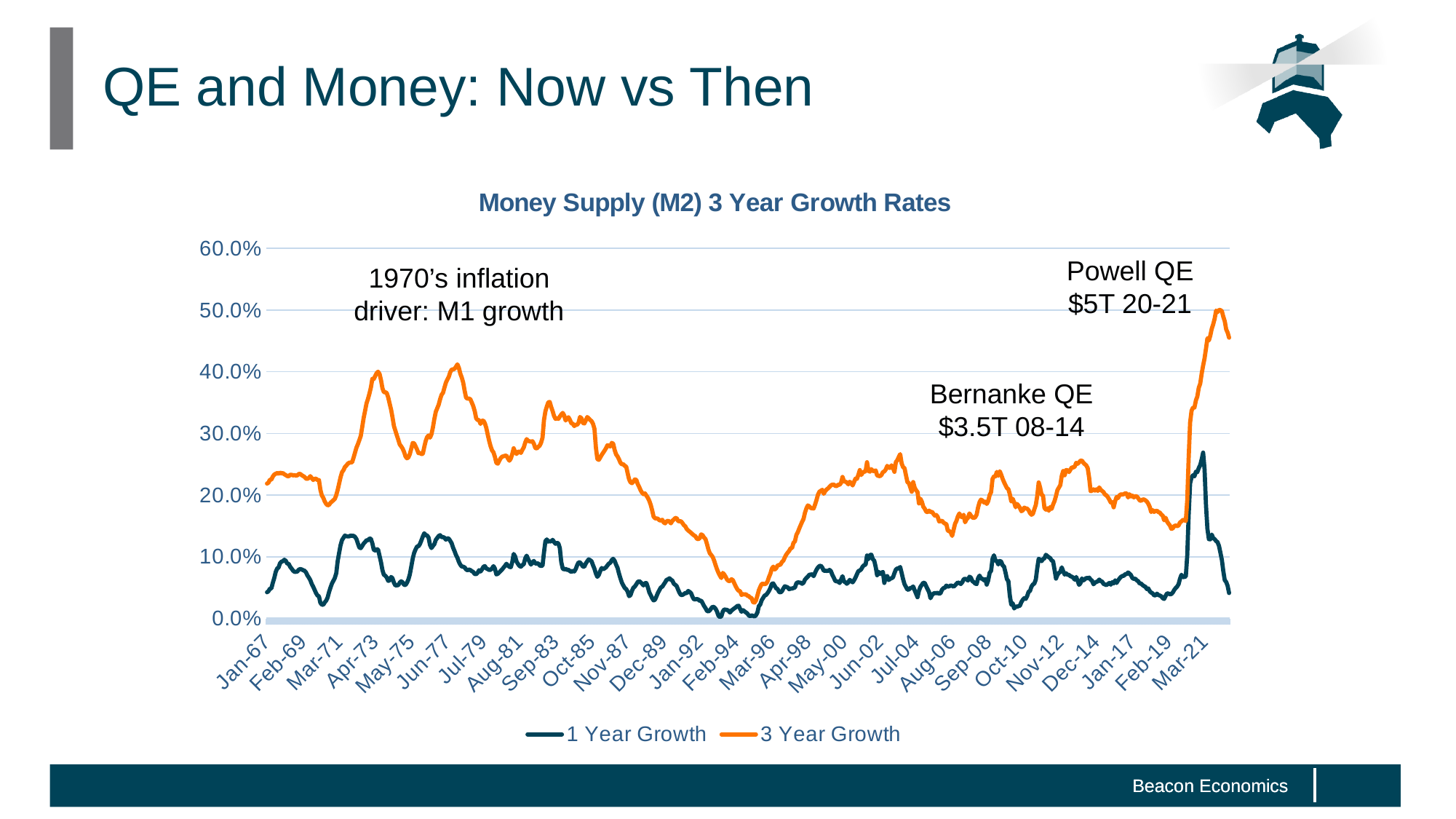
Which series reaches the highest value anywhere on the chart? 3 Year Growth Is the peak value of the 1 Year Growth line near Mar-21 greater or less than 20.0%? greater At Mar-21, which series has the higher value, 1 Year Growth or 3 Year Growth? 3 Year Growth Does the 3 Year Growth line rise or fall between Feb-19 and Mar-21? Rise What is the highest value shown on the y axis? 60.0% How many series does the legend list? 2 Near which x-axis label does the 3 Year Growth line reach its highest point? Mar-21 What is the title of the chart? Money Supply (M2) 3 Year Growth Rates Is the peak value of the 3 Year Growth line near Mar-21 greater or less than 40.0%? greater What kind of chart is shown on the slide? Line chart Which series is drawn in orange? 3 Year Growth Is the value of the 3 Year Growth line at Feb-94 greater or less than 10.0%? less